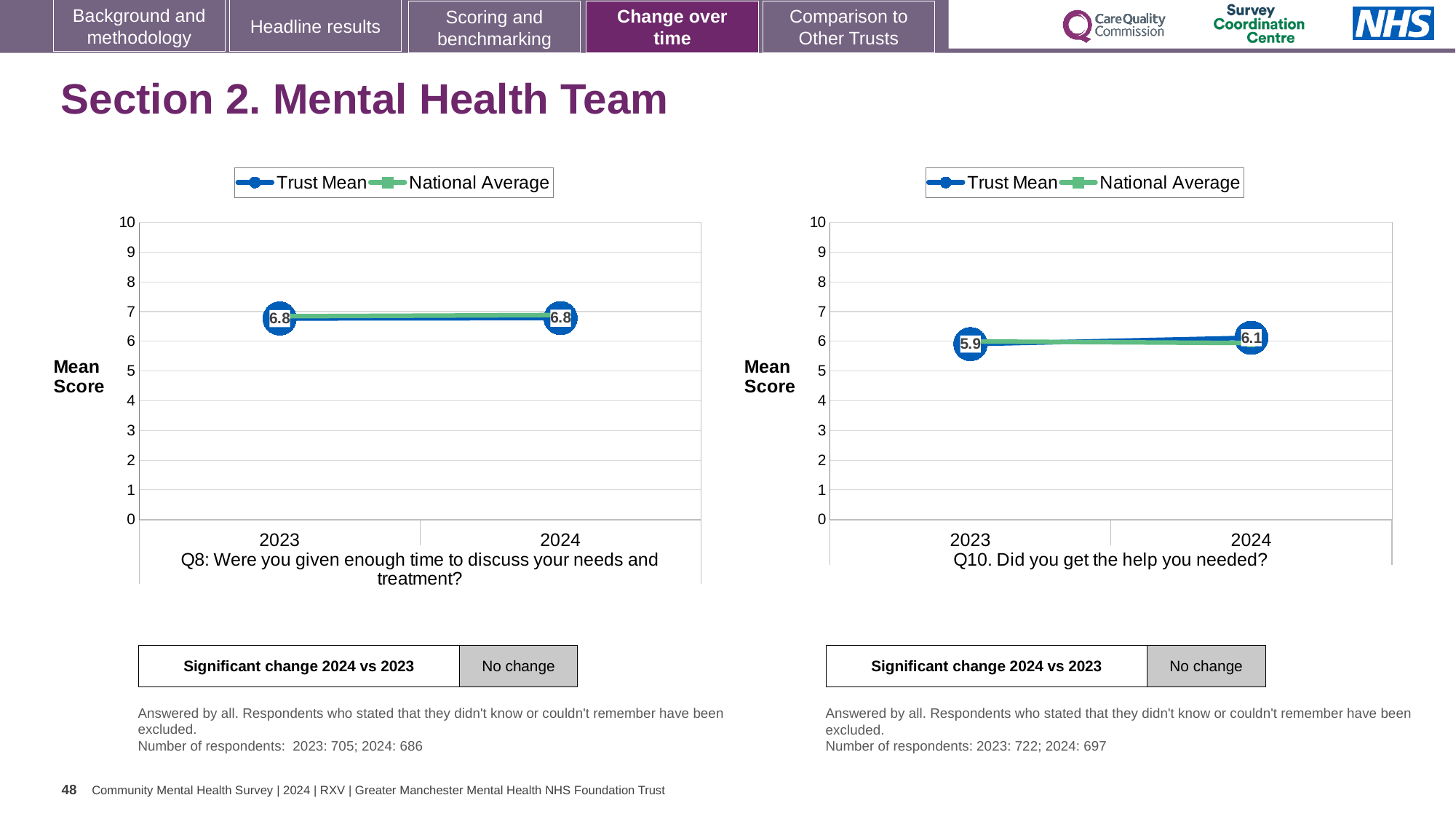
How many years are plotted on the x axis of the right chart (Q10)? 2 In the right chart (Q10), which year has the higher Trust Mean, 2023 or 2024? 2024 In the left chart (Q8), is the Trust Mean for 2024 greater or less than 5? greater In the left chart (Q8: Were you given enough time to discuss your needs and treatment?), what is the Trust Mean for 2023? 6.8 In the right chart (Q10. Did you get the help you needed?), what is the Trust Mean for 2023? 5.9 In the right chart (Q10), does the Trust Mean rise or fall from 2023 to 2024? rise In the right chart (Q10), what is the difference between the Trust Mean for 2024 and 2023? 0.2 In the right chart (Q10), is the Trust Mean for 2023 greater or less than 7? less What kind of chart is the left chart (Q8)? line chart In the left chart (Q8), what is the Trust Mean for 2024? 6.8 How many series does the legend of the left chart (Q8) list? 2 In the right chart (Q10), what is the Trust Mean for 2024? 6.1